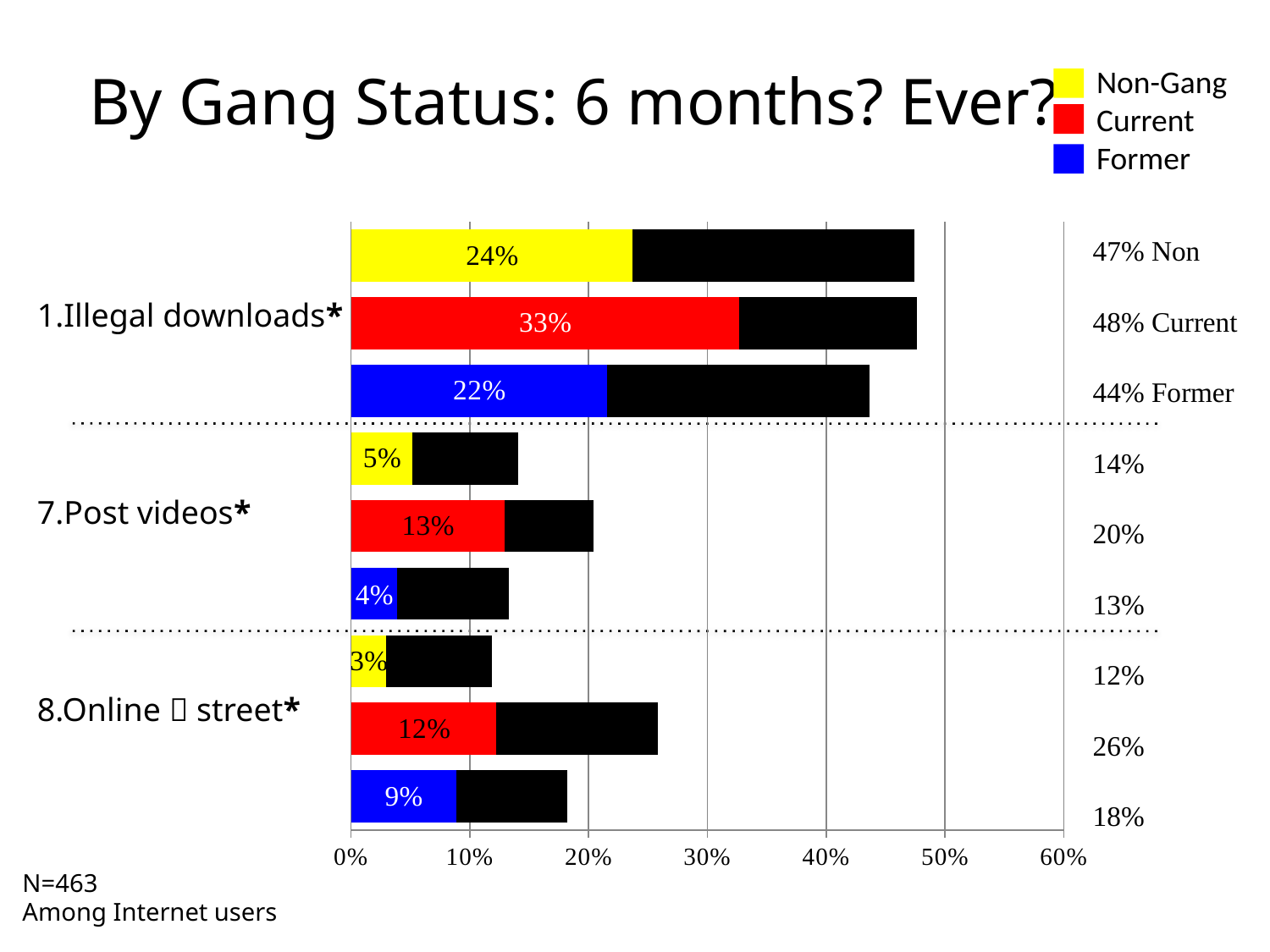
Which gang status group has the lowest 6-month value for Online → street? Non-Gang What colour represents Former gang members in the legend? blue Which gang status group has the highest 6-month value for Illegal downloads? Current What is the difference between the Current and Former 6-month values for Post videos? 9% How many series does the legend list? 3 Is the 6-month value for Former gang members for Online → street larger or smaller than the 6-month value for Non-Gang respondents for Online → street? larger What is the 6-month value (coloured segment) for Current gang members for Illegal downloads? 33% What is the 'Ever' total shown at the right for Current gang members for Online → street? 26% What kind of chart is shown on the slide? bar chart What is the 'Ever' total shown at the right for Former gang members for Illegal downloads? 44% What is the 6-month value for Non-Gang respondents for Post videos? 5% Is the 'Ever' total for Current gang members for Illegal downloads greater or less than 40%? greater